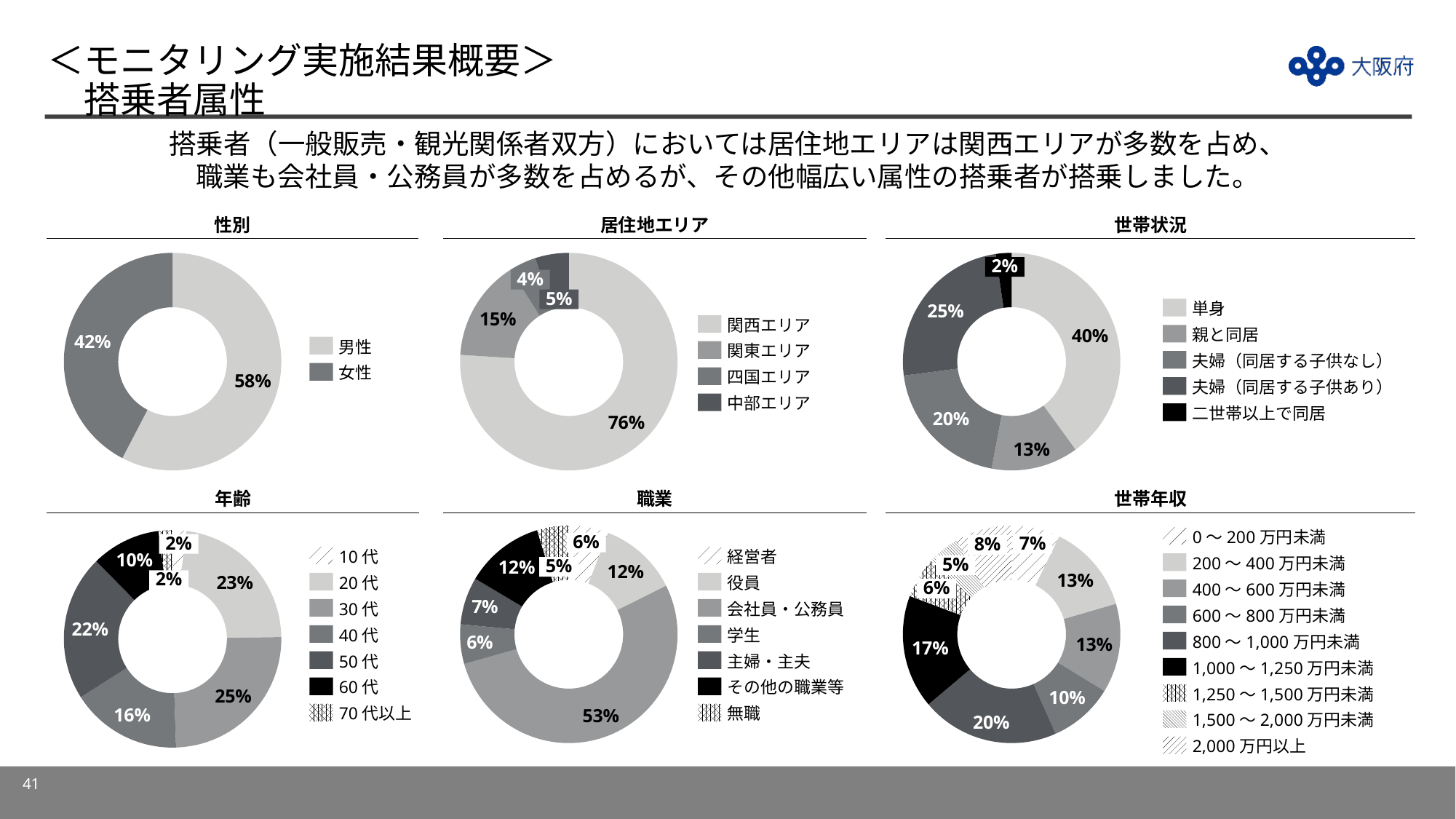
In the 年齢 chart, which age group has the largest share? 30 代 In the 性別 chart, what percentage is 男性? 58% In the 居住地エリア chart, what percentage is 関西エリア? 76% In the 職業 chart, which is larger, 役員 or 主婦・主夫? 役員 In the 世帯年収 chart, what percentage is 800 ～ 1,000 万円未満? 20% In the 居住地エリア chart, which area has the largest share? 関西エリア In the 年齢 chart, what percentage is 50 代? 22% How many categories does the legend of the 世帯年収 chart list? 9 In the 世帯状況 chart, what percentage is 夫婦（同居する子供あり）? 25% In the 世帯状況 chart, which category has the smallest share? 二世帯以上で同居 In the 性別 chart, what is the difference between 男性 and 女性? 16% In the 職業 chart, what percentage is 会社員・公務員? 53%